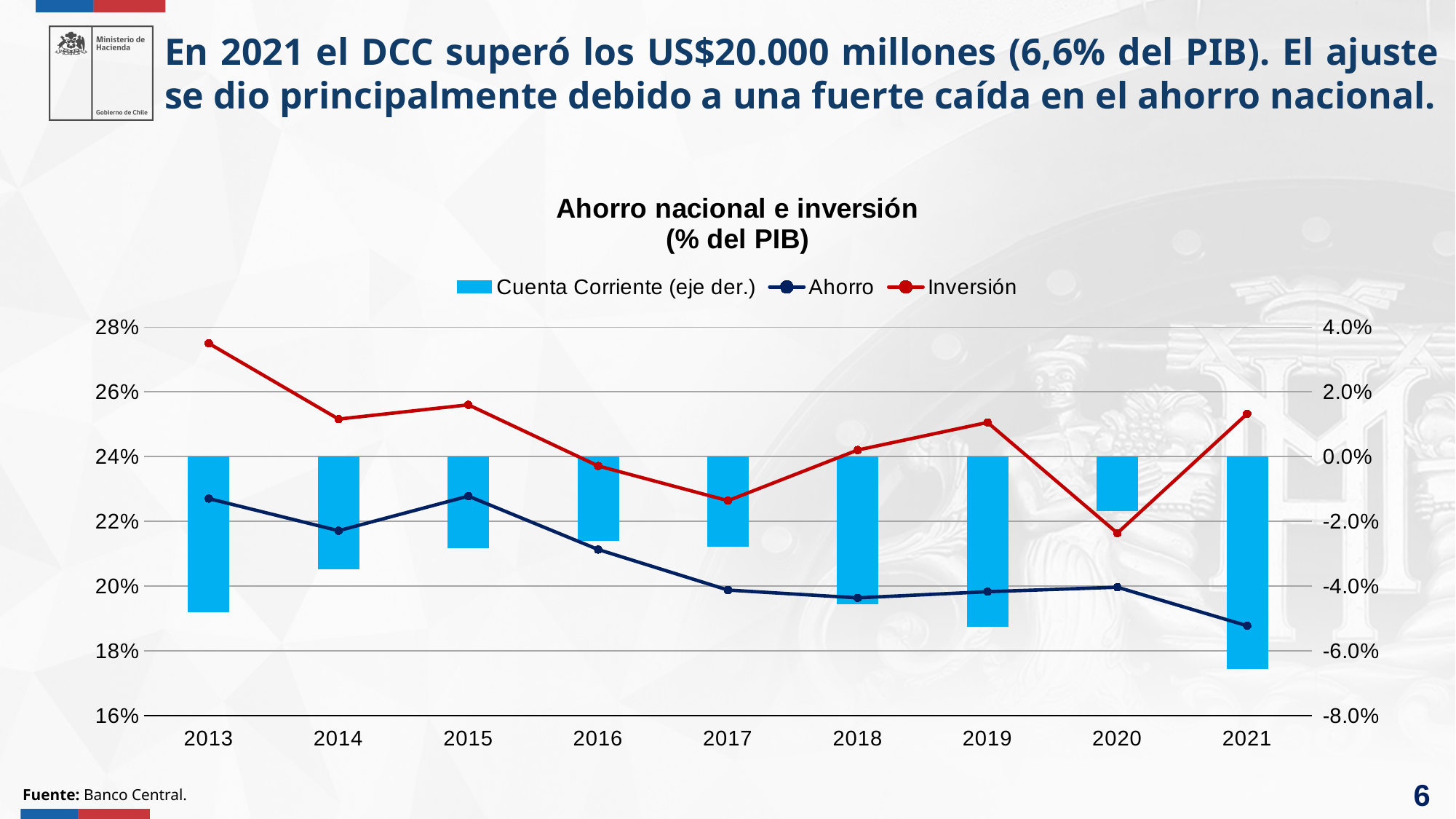
In which year is Inversión lowest? 2020 Which series is plotted on the right-hand axis? Cuenta Corriente In which year is the Cuenta Corriente bar most negative? 2021 Is the value for Ahorro in 2021 greater or less than 20%? less Is the value for Cuenta Corriente in 2021 greater or less than -6.0%? less How many years are shown on the x axis? 9 In which year is Inversión highest? 2013 Is the value for Inversión in 2013 greater or less than 26%? greater What kind of chart is shown on the slide? A combined bar and line chart How many series does the legend list? 3 In which year is Ahorro lowest? 2021 Which is larger, Ahorro in 2013 or Ahorro in 2021? Ahorro in 2013